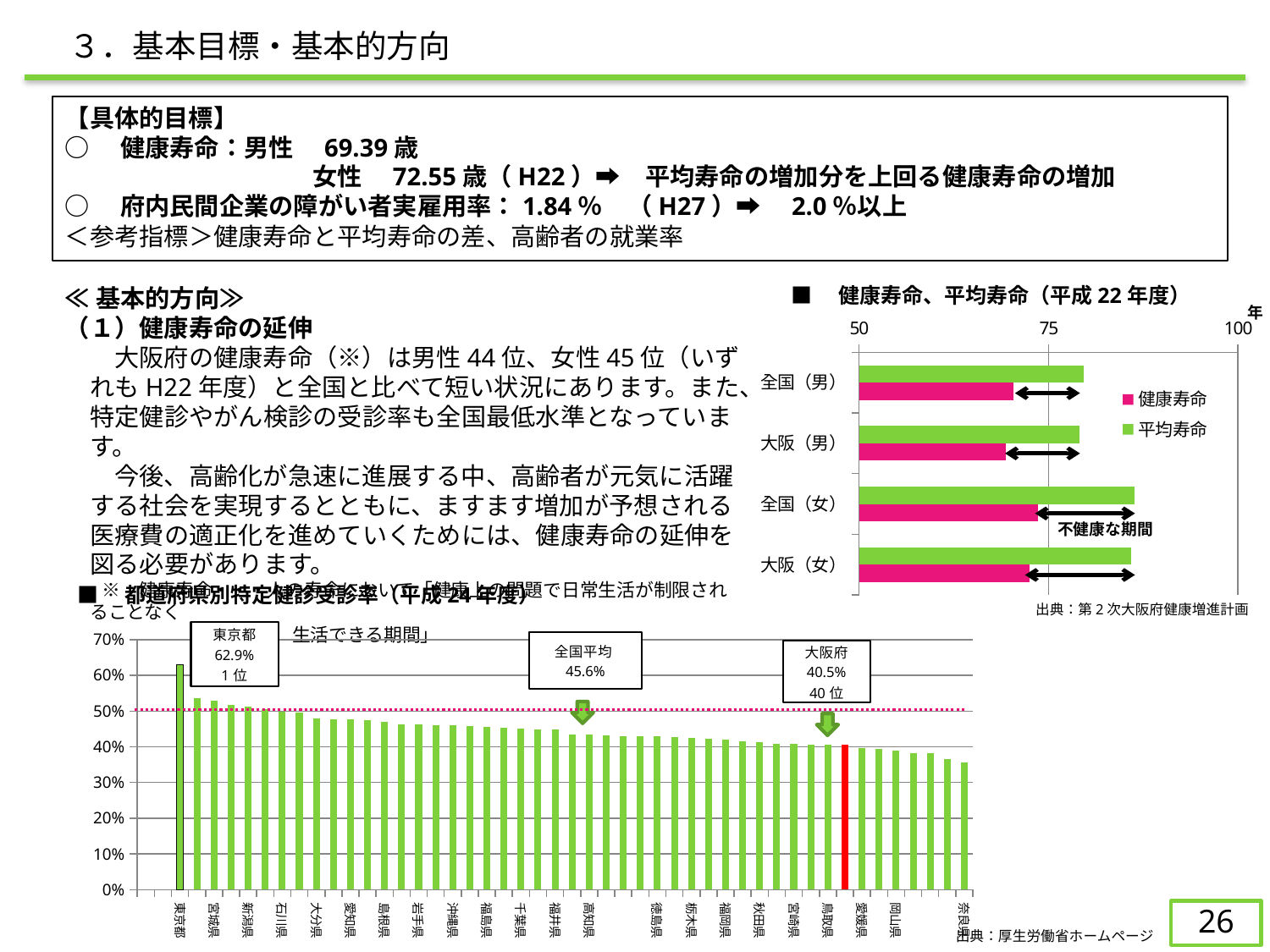
In the 健康寿命、平均寿命（平成22年度） chart, is the 健康寿命 value for 大阪（男） greater or less than 75? less How many series does the legend of the 健康寿命、平均寿命（平成22年度） chart list? 2 In the 健康寿命、平均寿命（平成22年度） chart, which is larger: the 平均寿命 for 全国（男） or for 全国（女）? 全国（女） In the 都道府県別特定健診受診率（平成24年度） chart, what is the value for 大阪府? 40.5% In the 都道府県別特定健診受診率（平成24年度） chart, what is the difference between the 全国平均 (45.6%) and the value for 大阪府? 5.1% In the 都道府県別特定健診受診率（平成24年度） chart, do the values rise or fall from left to right? fall In the 都道府県別特定健診受診率（平成24年度） chart, what is the value for 東京都? 62.9% How many categories are shown in the 健康寿命、平均寿命（平成22年度） chart? 4 What kind of chart is the 健康寿命、平均寿命（平成22年度） chart on the right? bar chart What are the two legend entries in the 健康寿命、平均寿命（平成22年度） chart? 健康寿命, 平均寿命 What kind of chart is the 都道府県別特定健診受診率（平成24年度） chart at the bottom? bar chart In the 健康寿命、平均寿命（平成22年度） chart, is the 平均寿命 value for 全国（男） greater or less than 75? greater